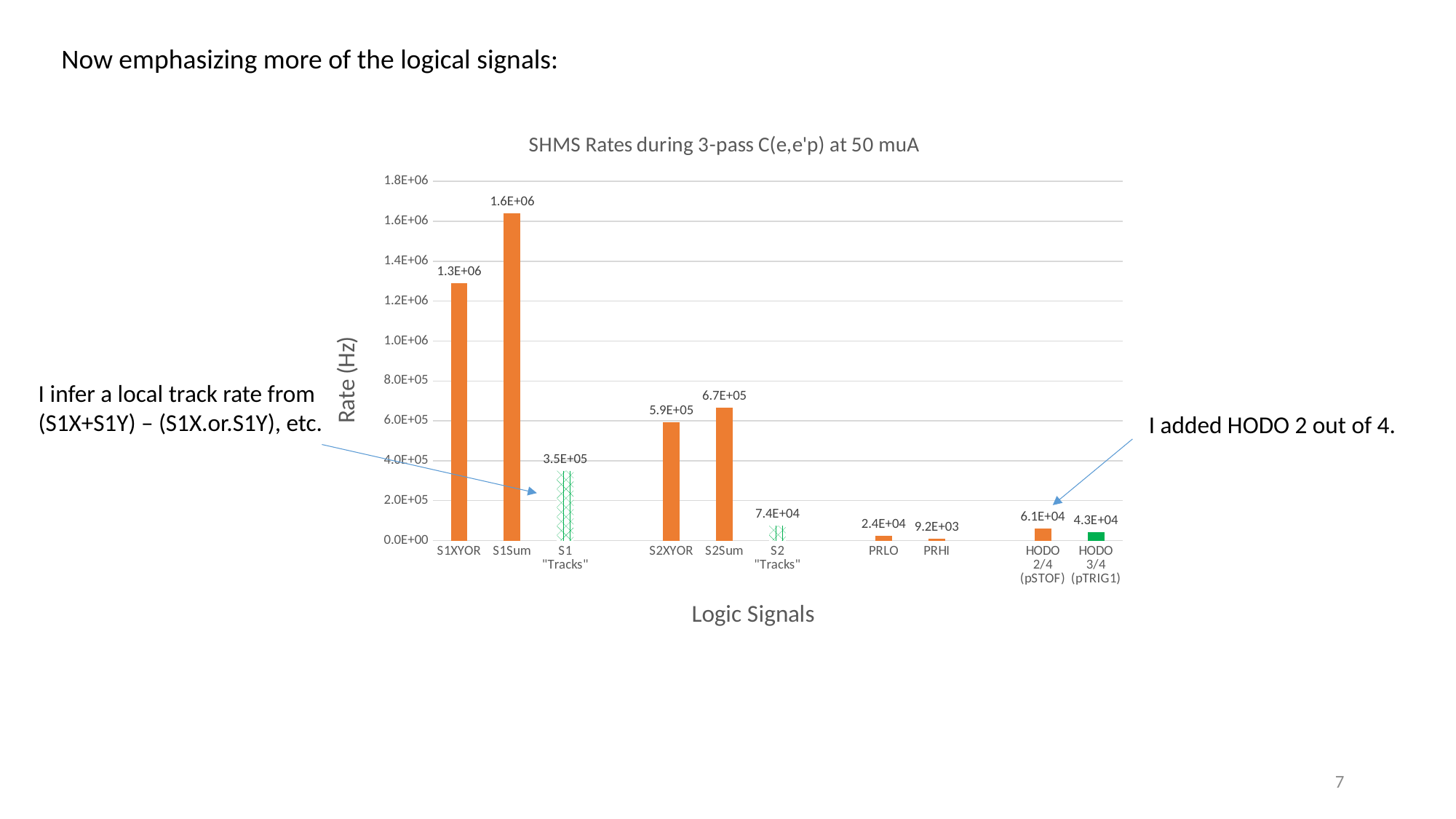
What is the rate for HODO 2/4 (pSTOF)? 6.1E+04 What is the title of the chart? SHMS Rates during 3-pass C(e,e'p) at 50 muA What type of chart is shown on the slide? bar chart Which logic signal has the highest rate? S1Sum Is the value for S1 "Tracks" greater or less than 4.0E+05? less How many logic signals are plotted on the x axis? 10 Which logic signal has the lowest rate? PRHI What is the rate for S2XYOR? 5.9E+05 Which has a higher rate, S2Sum or S2XYOR? S2Sum What is the rate for PRHI? 9.2E+03 What is the label of the y axis? Rate (Hz) What is the rate for S1Sum? 1.6E+06